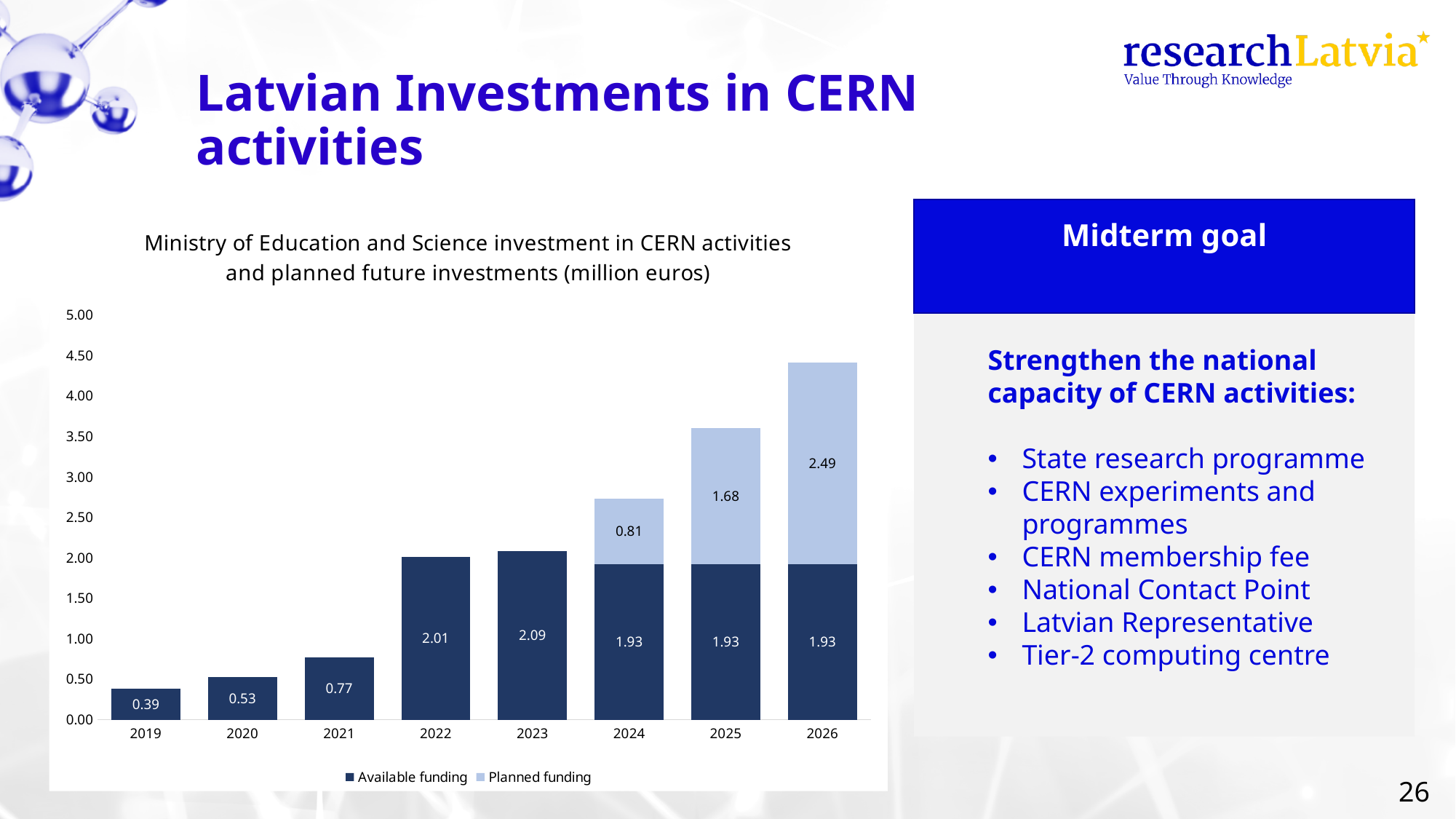
What is the total of the stacked bar for 2026? 4.42 How many years are shown on the x axis? 8 What is the total of the stacked bar for 2024? 2.74 What is the Available funding value for 2022? 2.01 Which year has the highest Planned funding value? 2026 Which year has the lowest Available funding value? 2019 What kind of chart is shown on the slide? Stacked bar chart What is the Available funding value for 2019? 0.39 What is the difference between the Planned funding values for 2026 and 2024? 1.68 How many series does the legend list? 2 What is the Planned funding value for 2025? 1.68 Which is larger, the Available funding for 2023 or for 2022? 2023